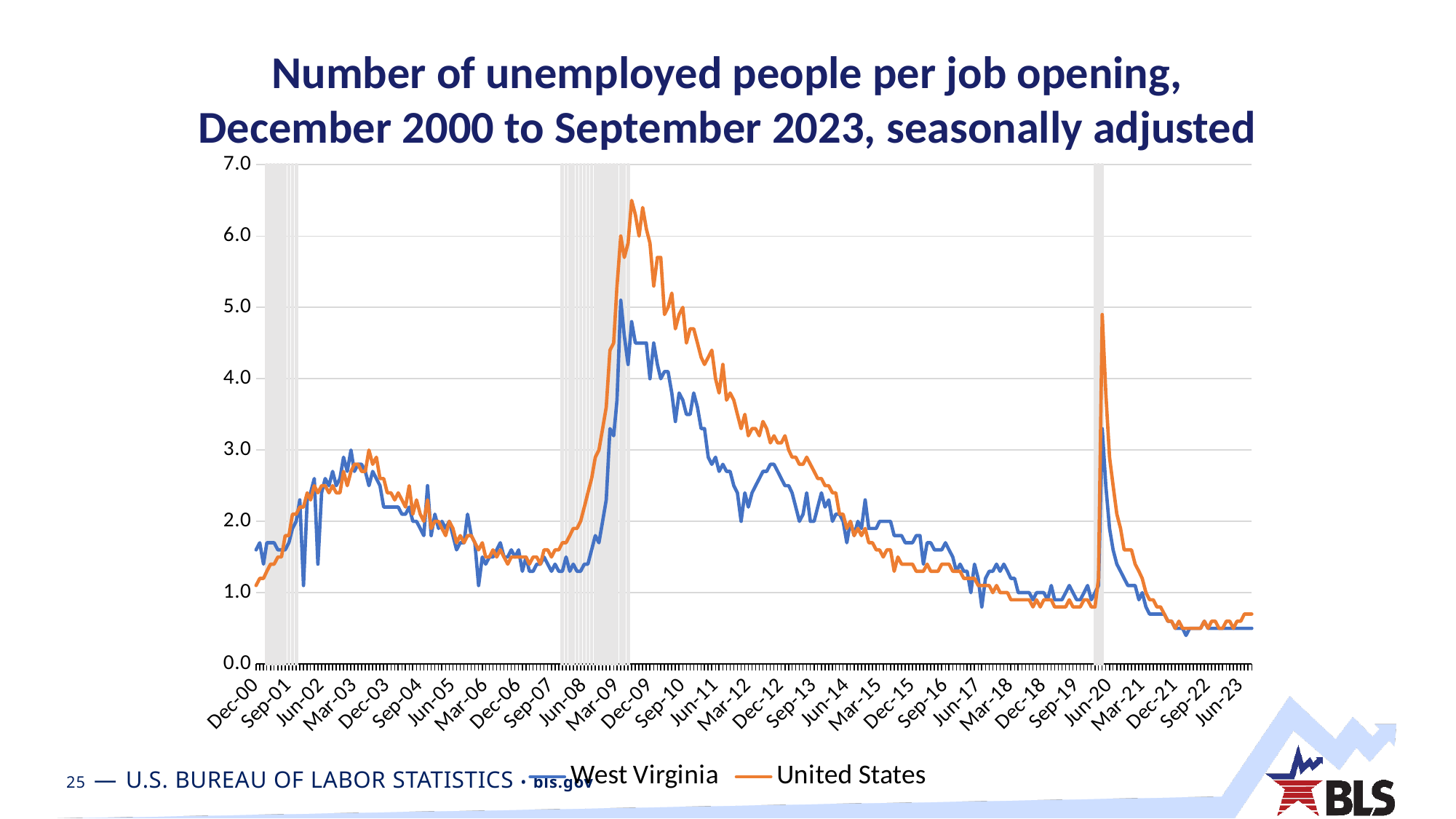
Is the spike value for West Virginia around Jun-20 greater or less than 4.0? less Which series is higher around Dec-15, West Virginia or United States? West Virginia Which two series are plotted in the chart? West Virginia and United States Is the peak value for the United States around Dec-09 greater or less than 6.0? greater What kind of chart is shown on the slide? line chart Is the peak value for West Virginia around Dec-09 greater or less than 4.0? greater Do the values for the United States rise or fall between Dec-09 and Dec-19? fall Which series reaches the higher peak around Dec-09, West Virginia or United States? United States Which colour is used for the West Virginia line? blue How many series does the legend list? 2